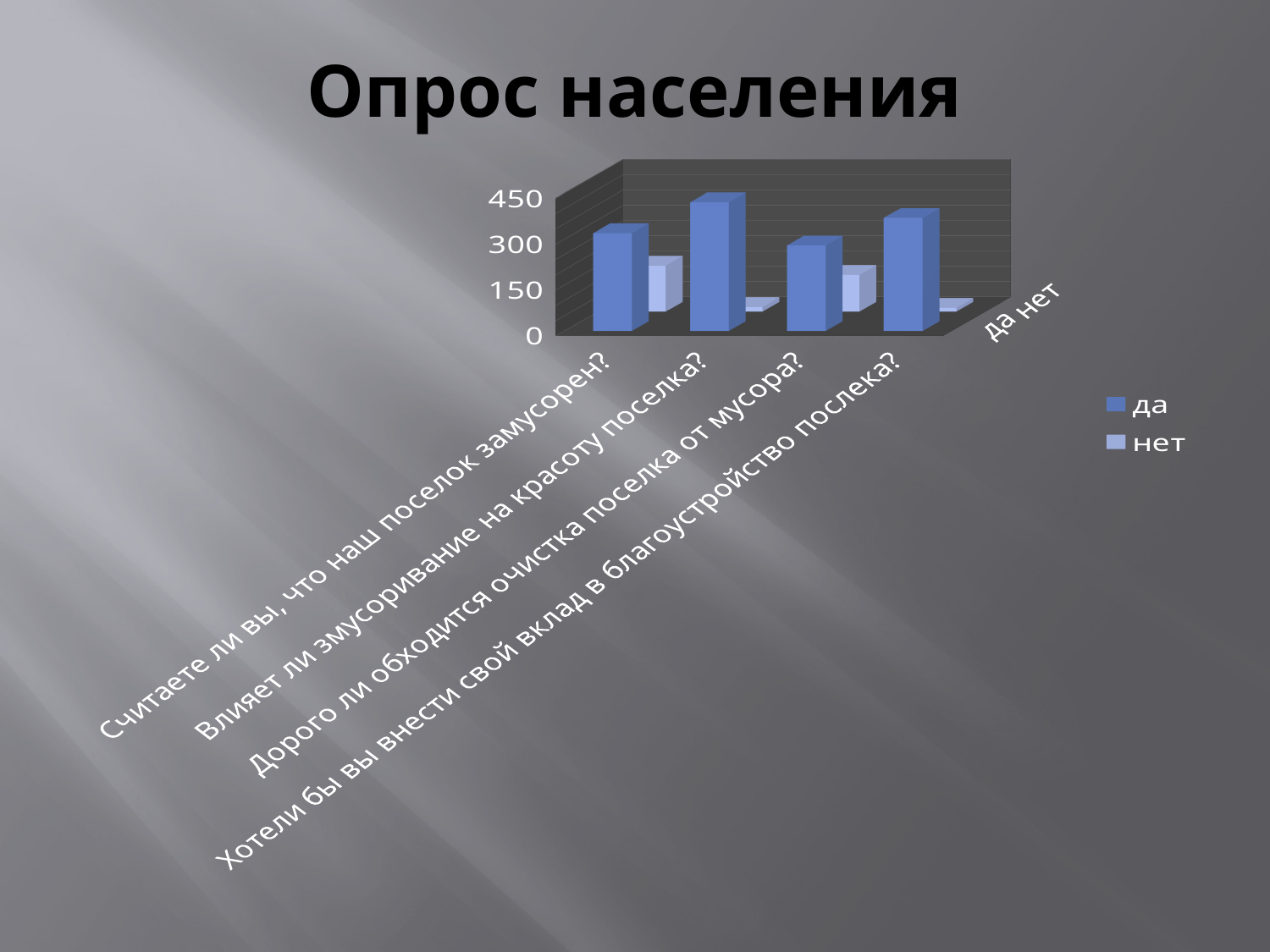
Is the "нет" value for "Хотели бы вы внести свой вклад в благоустройство послека?" greater or less than 150? less Is the "да" value for "Хотели бы вы внести свой вклад в благоустройство послека?" greater or less than 300? greater Is the "да" value for "Влияет ли змусоривание на красоту поселка?" greater or less than 300? greater For which survey question is the "да" bar the highest? Влияет ли змусоривание на красоту поселка? For "Считаете ли вы, что наш поселок замусорен?", which is larger: the "да" value or the "нет" value? да What is the title of the slide containing the chart? Опрос населения Which is larger: the "да" value for "Влияет ли змусоривание на красоту поселка?" or the "да" value for "Дорого ли обходится очистка поселка от мусора?"? Влияет ли змусоривание на красоту поселка? What are the two series named in the legend? да, нет How many survey questions (categories) are plotted on the chart? 4 What kind of chart is shown on the slide? bar chart How many series does the chart legend list? 2